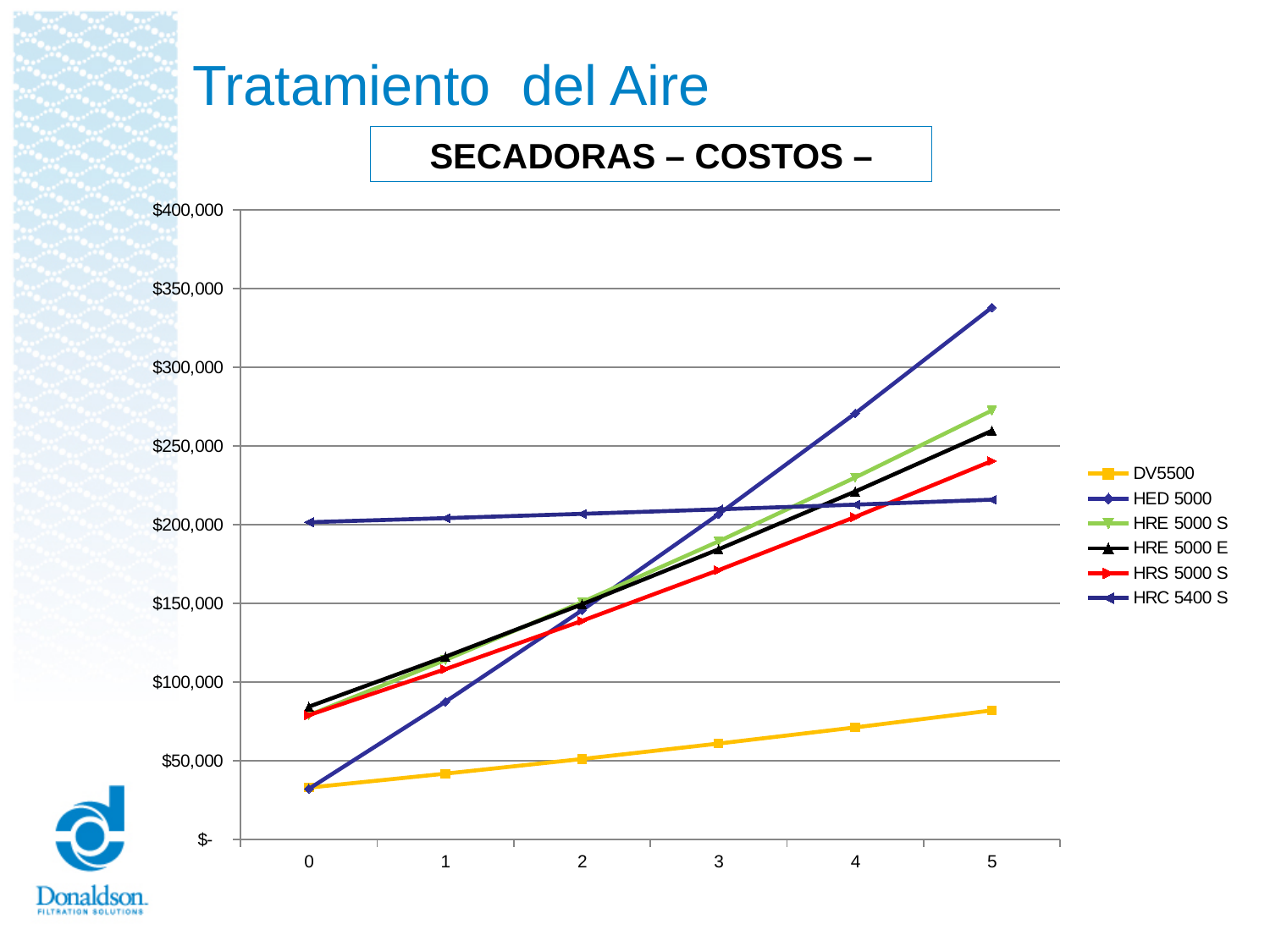
Is the value for HED 5000 at x = 5 greater or less than $300,000? greater Which series has the highest value at x = 0? HRC 5400 S Which series has the lowest value at x = 5? DV5500 Which series has the highest value at x = 5? HED 5000 At x = 5, which is larger: HRE 5000 S or HRS 5000 S? HRE 5000 S Does the DV5500 series rise or fall from x = 0 to x = 5? rise What kind of chart is shown on the slide? line chart How many series does the legend list? 6 Is the value for DV5500 at x = 5 greater or less than $100,000? less At x = 1, which is larger: HED 5000 or HRS 5000 S? HRS 5000 S Is the value for HRC 5400 S at x = 0 greater or less than $150,000? greater How many points are plotted along the x axis for each series? 6